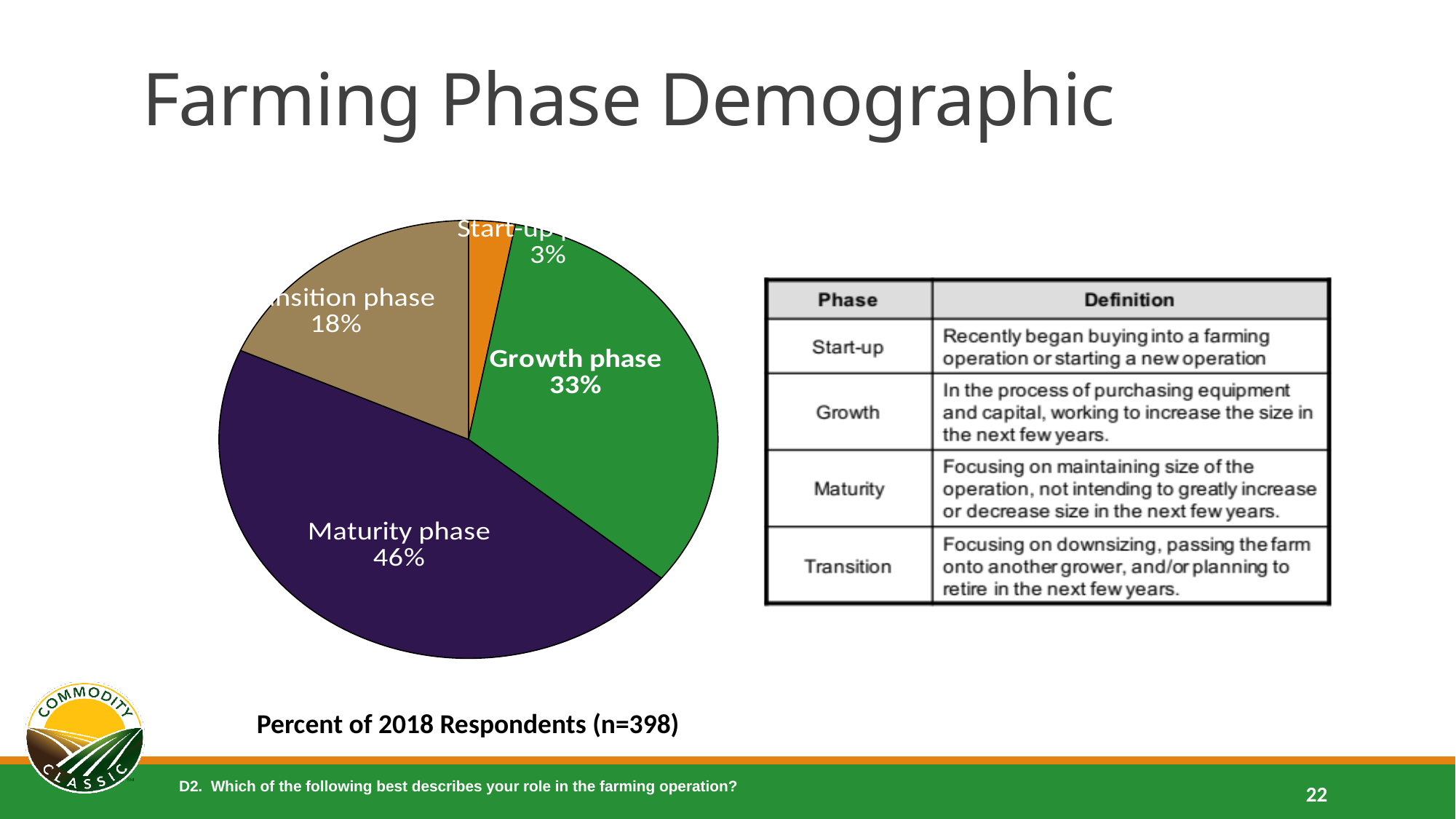
What colour is the Maturity phase slice in the pie chart? dark purple Which farming phase has the smallest share of respondents? Start-up phase What is the difference in percentage points between the Maturity phase and the Growth phase? 13 Which is larger, the Transition phase share or the Growth phase share? Growth phase What is the combined share of the Growth phase and Transition phase slices? 51% What percentage of respondents are in the Start-up phase? 3% What type of chart is shown on the slide? pie chart What percentage of respondents are in the Maturity phase? 46% What percentage of respondents are in the Growth phase? 33% What percentage of respondents are in the Transition phase? 18% How many slices does the pie chart have? 4 Which farming phase has the largest share of respondents? Maturity phase